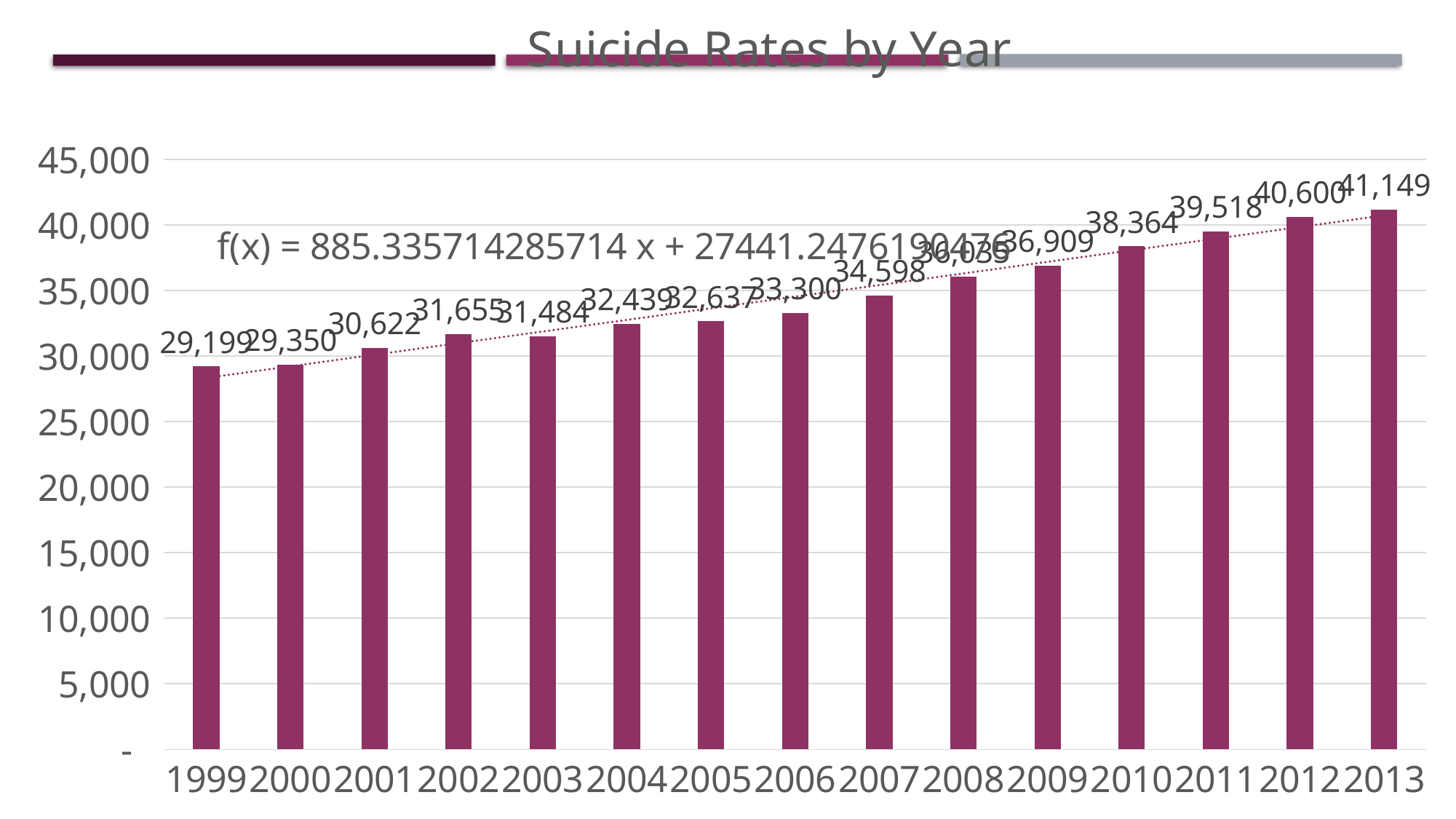
What is the value for 1999? 29,199 What is the value for 2013? 41,149 Is the value for 2005 greater or less than 30,000? greater Which year has the highest value? 2013 Which year has the lowest value? 1999 How many years are shown on the x axis? 15 What is the value for 2011? 39,518 Which is larger, the value for 2010 or the value for 2007? 2010 What is the difference between the values for 2013 and 1999? 11,950 Do the values generally rise or fall from 1999 to 2013? rise What is the difference between the values for 2012 and 2011? 1,082 What kind of chart is this? bar chart